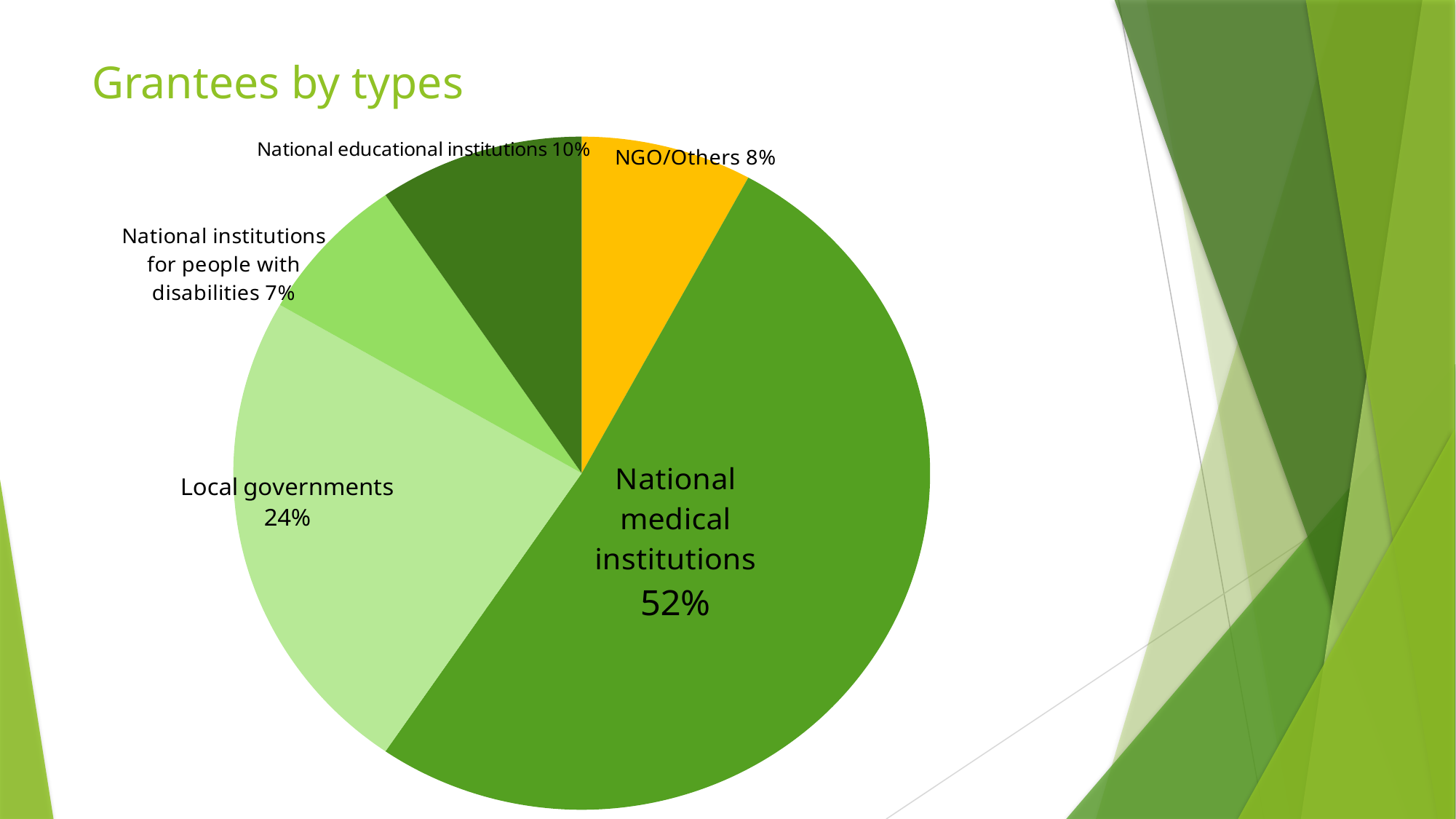
What share of grantees are Local governments? 24% What is the difference in percentage points between National medical institutions and Local governments? 28 Which grantee type has the largest share? National medical institutions What is the title of the chart? Grantees by types What share of grantees are National educational institutions? 10% Which grantee type has the smallest share? National institutions for people with disabilities What type of chart is shown on the slide? pie chart What share of grantees are NGO/Others? 8% Which has a larger share, National educational institutions or NGO/Others? National educational institutions What share of grantees are National medical institutions? 52% What share of grantees are National institutions for people with disabilities? 7% How many grantee types are shown in the pie chart? 5